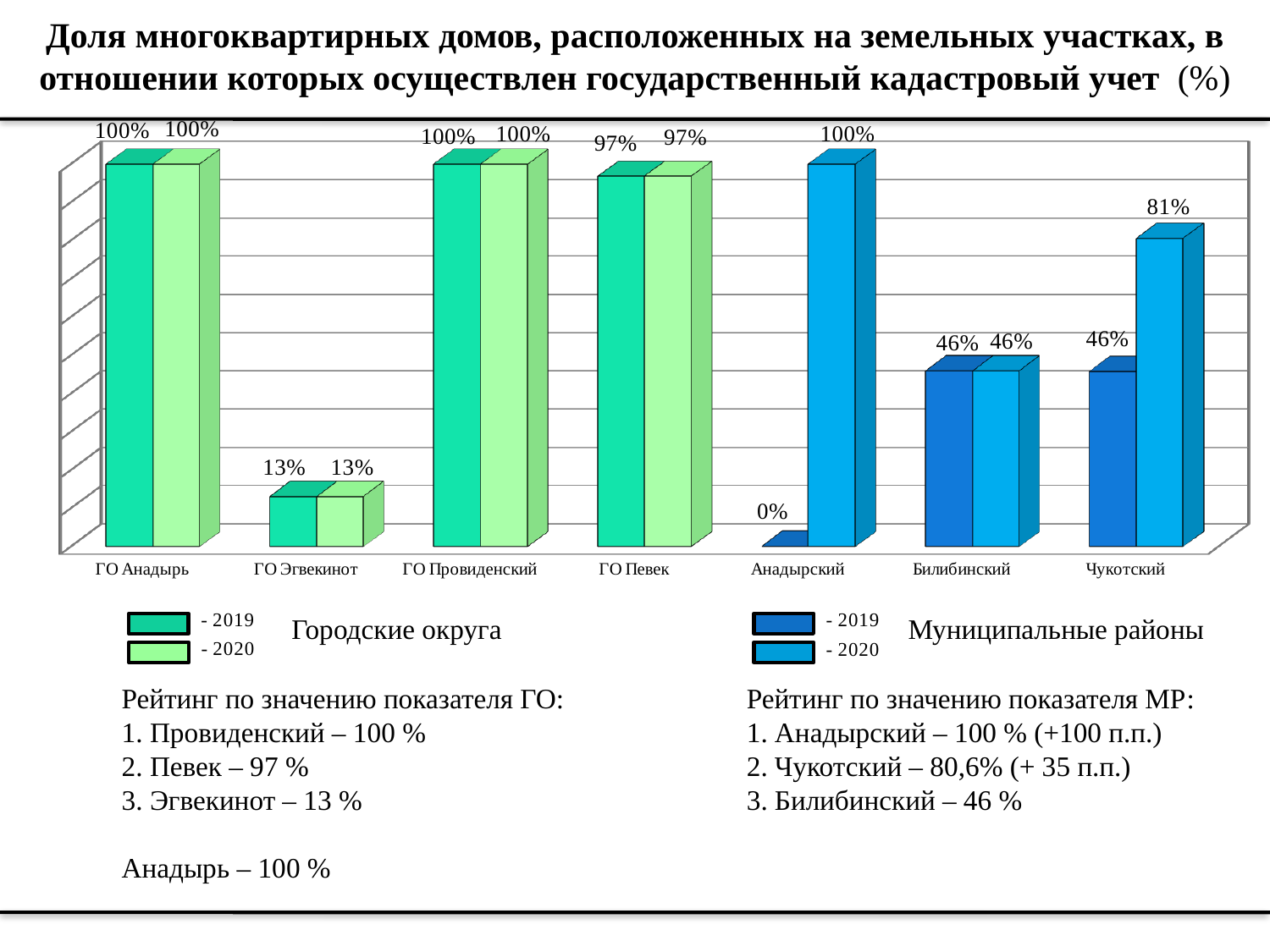
How many categories are shown on the x axis? 7 Which is larger in 2020: ГО Певек or Билибинский? ГО Певек Which category has the lowest value in 2020? ГО Эгвекинот What is the value for ГО Эгвекинот in 2020? 13% What is the value for Чукотский in 2020? 81% What is the value for ГО Певек in 2019? 97% By how many percentage points did the value for Чукотский change from 2019 to 2020? 35 What kind of chart is shown on the slide? Bar chart What is the value for Анадырский in 2019? 0% By how many percentage points did the value for Анадырский change from 2019 to 2020? 100 Did the value for Чукотский rise or fall from 2019 to 2020? Rise Which category has the lowest value in 2019? Анадырский